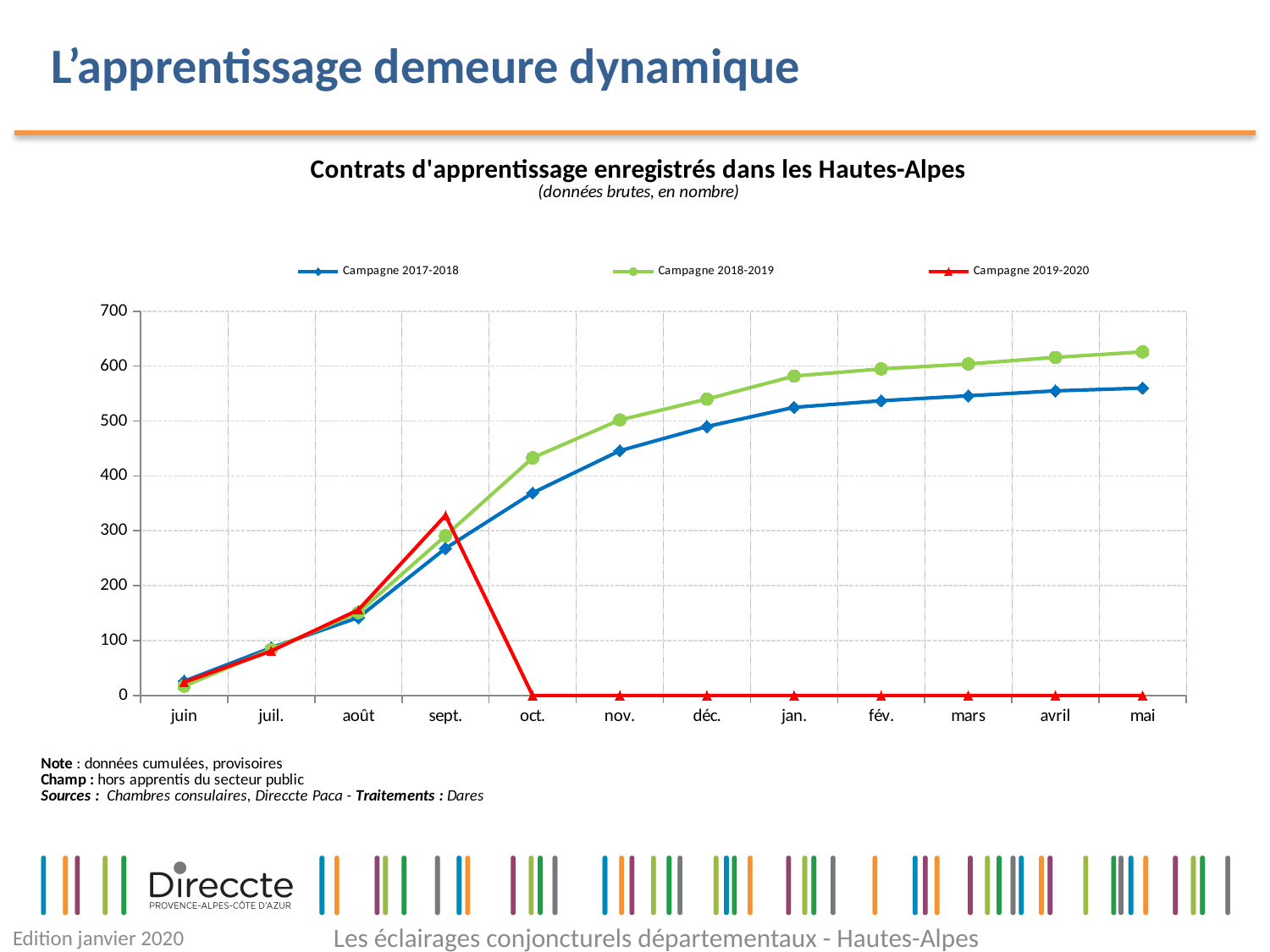
In which month is the value for Campagne 2018-2019 lowest? juin In which month does Campagne 2017-2018 reach its highest value? mai Is the value for Campagne 2018-2019 in mai greater or less than 600? greater How many series does the legend list? 3 In mai, which series has the higher value, Campagne 2017-2018 or Campagne 2018-2019? Campagne 2018-2019 What kind of chart is shown on the slide? line chart In sept., which series has the higher value, Campagne 2019-2020 or Campagne 2017-2018? Campagne 2019-2020 Is the value for Campagne 2017-2018 in mai greater or less than 600? less What is the title of the chart? Contrats d'apprentissage enregistrés dans les Hautes-Alpes Do the values for Campagne 2018-2019 rise or fall from juin to mai? rise How many months are shown on the x axis? 12 Is the value for Campagne 2017-2018 in oct. greater or less than 400? less